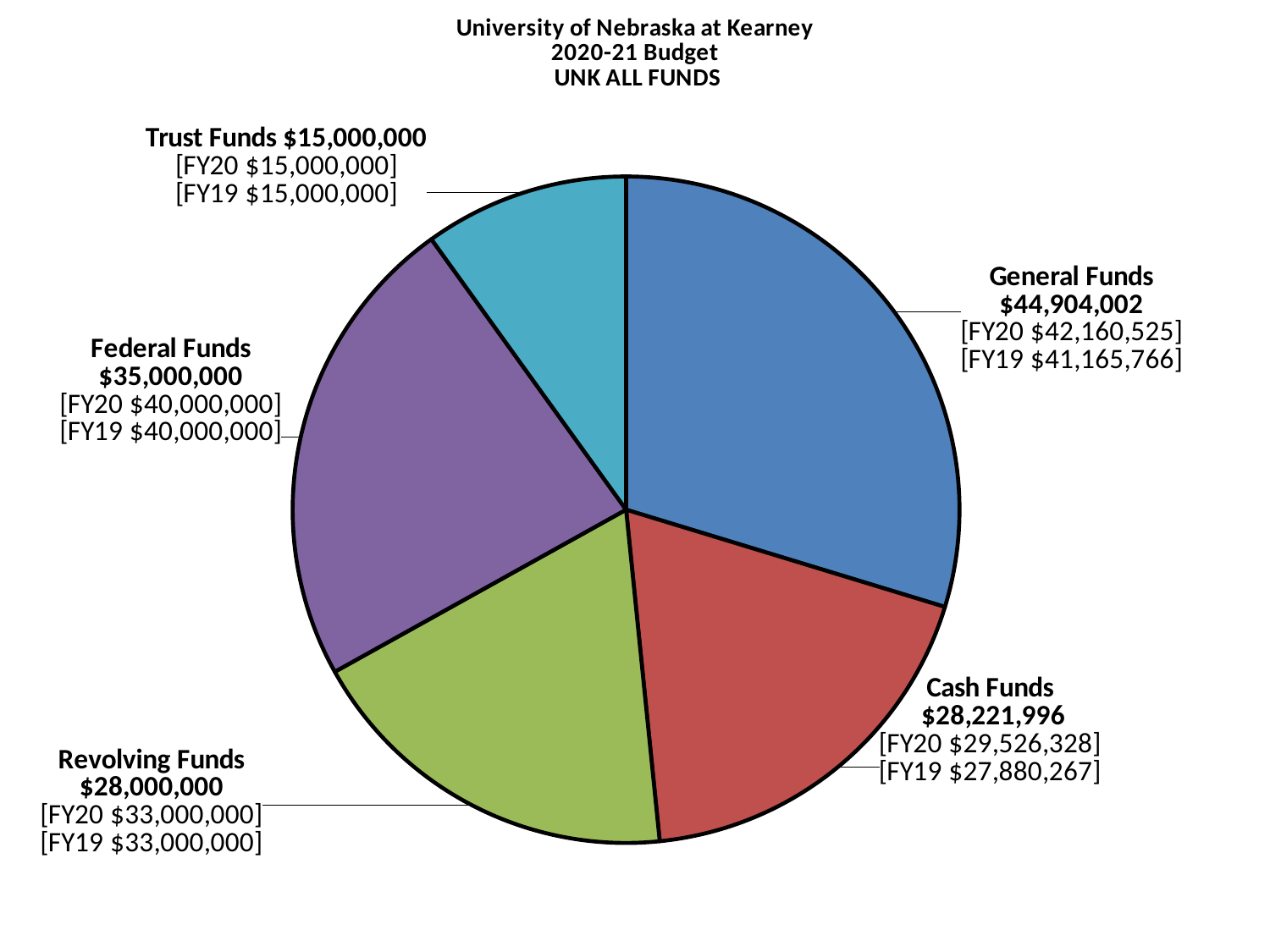
Which fund category has the smallest slice of the pie? Trust Funds What is the 2020-21 budget value for General Funds? $44,904,002 What is the title of the chart? University of Nebraska at Kearney 2020-21 Budget UNK ALL FUNDS What is the 2020-21 budget value for Cash Funds? $28,221,996 What is the difference between the General Funds and Cash Funds values? $16,682,006 What is the FY20 value shown for Federal Funds? $40,000,000 What is the difference between the Federal Funds and Trust Funds values? $20,000,000 What kind of chart is shown on the slide? pie chart Which is larger, Federal Funds or Revolving Funds? Federal Funds Which fund category has the largest slice of the pie? General Funds How many fund categories does the pie chart show? 5 What is the FY19 value shown for Cash Funds? $27,880,267